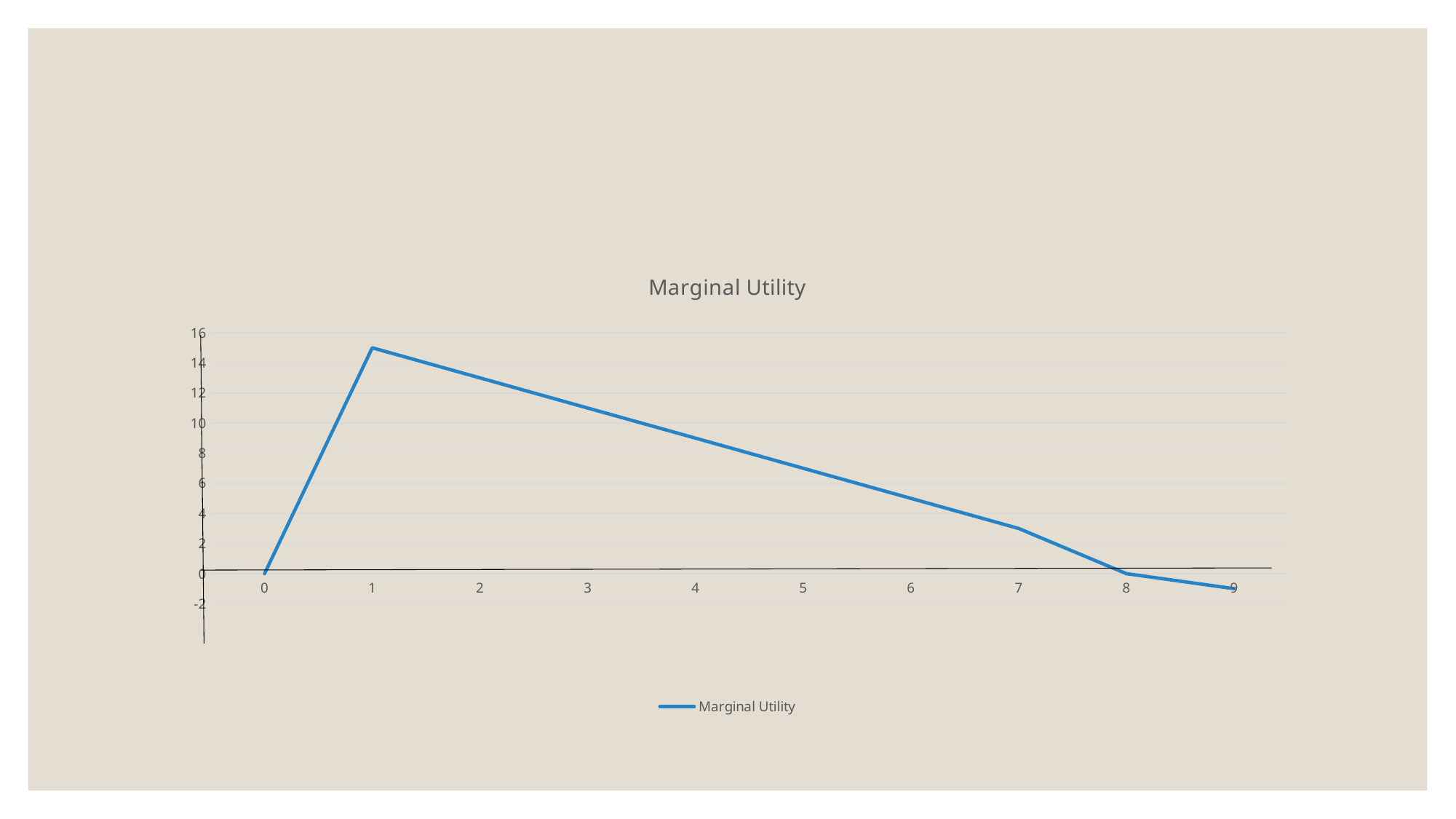
How many points are plotted on the Marginal Utility line? 10 Is the value of Marginal Utility at x = 1 greater or less than 14? greater At which x value does the Marginal Utility line reach its highest point? 1 What is the value of Marginal Utility at x = 0? 0 At which x value does the Marginal Utility line reach its lowest point? 9 What is the value of Marginal Utility at x = 8? 0 What kind of chart is shown on the slide? line chart Do the values of Marginal Utility rise or fall from x = 1 to x = 9? fall How many series does the legend list? 1 Is the value of Marginal Utility at x = 5 greater or less than 8? less What is the title of the chart? Marginal Utility Which is larger, the Marginal Utility at x = 2 or at x = 6? x = 2